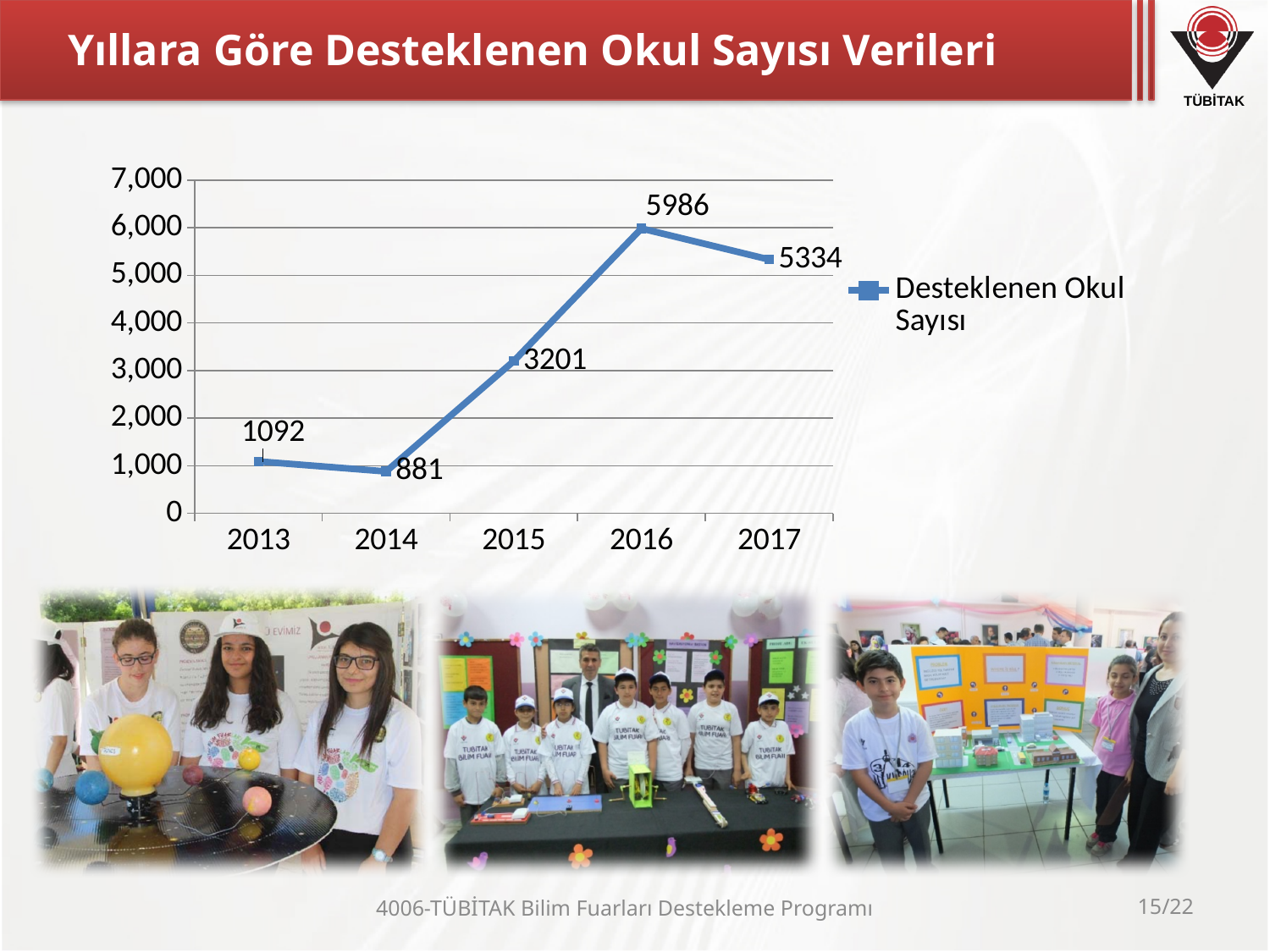
What kind of chart is shown on the slide? Line chart Is the value for 2015 greater or less than 3,000? greater Which year has the lowest number of supported schools? 2014 What is the difference between the number of supported schools in 2016 and 2017? 652 What is the number of supported schools (Desteklenen Okul Sayısı) in 2016? 5986 What is the number of supported schools in 2017? 5334 What is the series name shown in the chart legend? Desteklenen Okul Sayısı Which year has the highest number of supported schools? 2016 Which year has more supported schools, 2013 or 2015? 2015 What is the difference between the number of supported schools in 2015 and 2014? 2320 What is the number of supported schools in 2013? 1092 How many years are shown on the x axis of the chart? 5